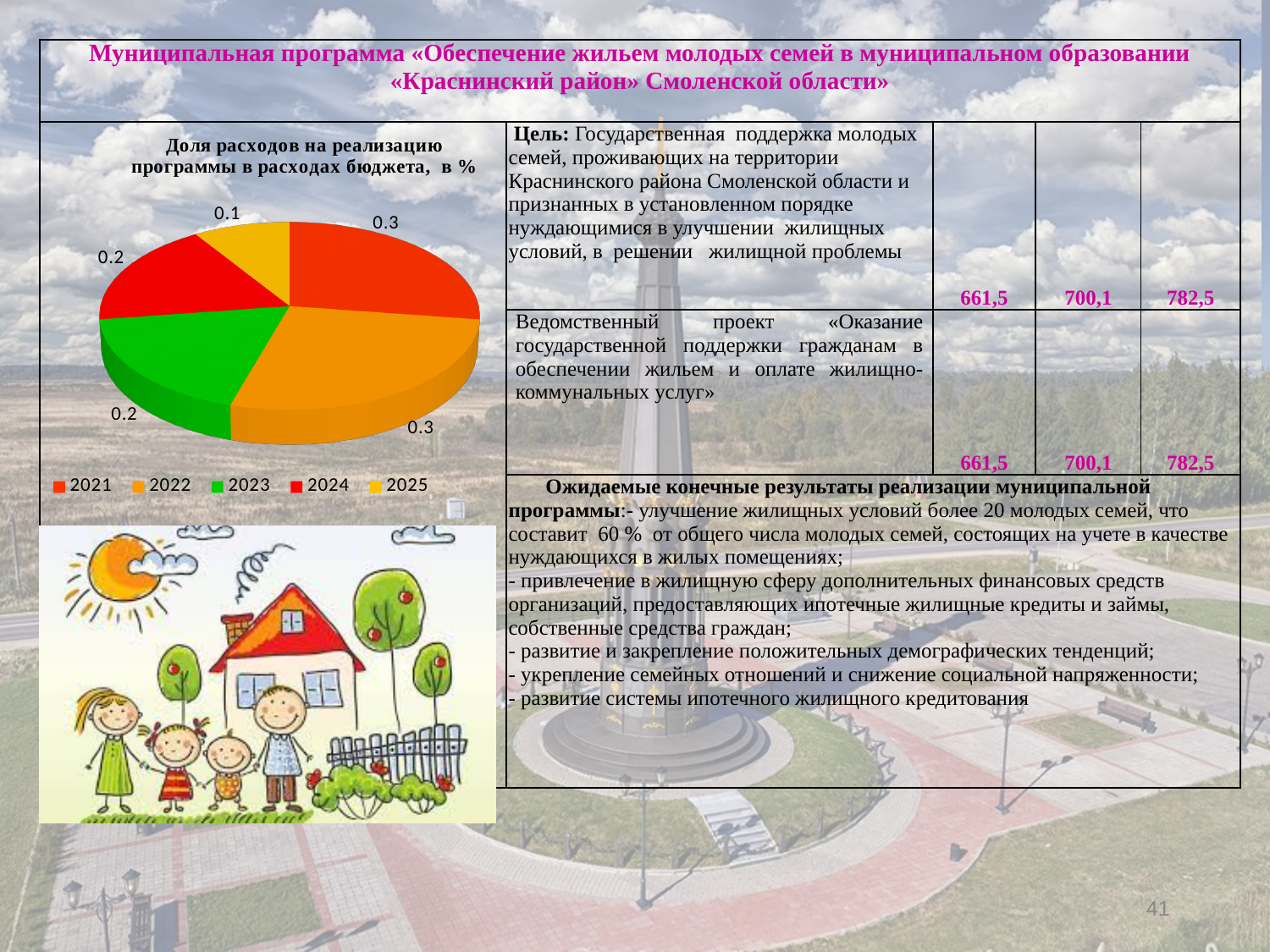
What is the difference between the values for 2021 and 2025 in the pie chart? 0.2 How many slices does the pie chart have? 5 What colour is the slice for 2023 in the pie chart? green Which is larger in the pie chart, the value for 2021 or the value for 2025? 2021 Which year has the smallest slice in the pie chart? 2025 What is the value shown for 2023 in the pie chart? 0.2 How many entries does the legend of the pie chart list? 5 What kind of chart is shown on the slide? pie chart What is the value shown for 2021 in the pie chart? 0.3 What is the value shown for 2024 in the pie chart? 0.2 What is the value shown for 2022 in the pie chart? 0.3 What is the value shown for 2025 in the pie chart? 0.1